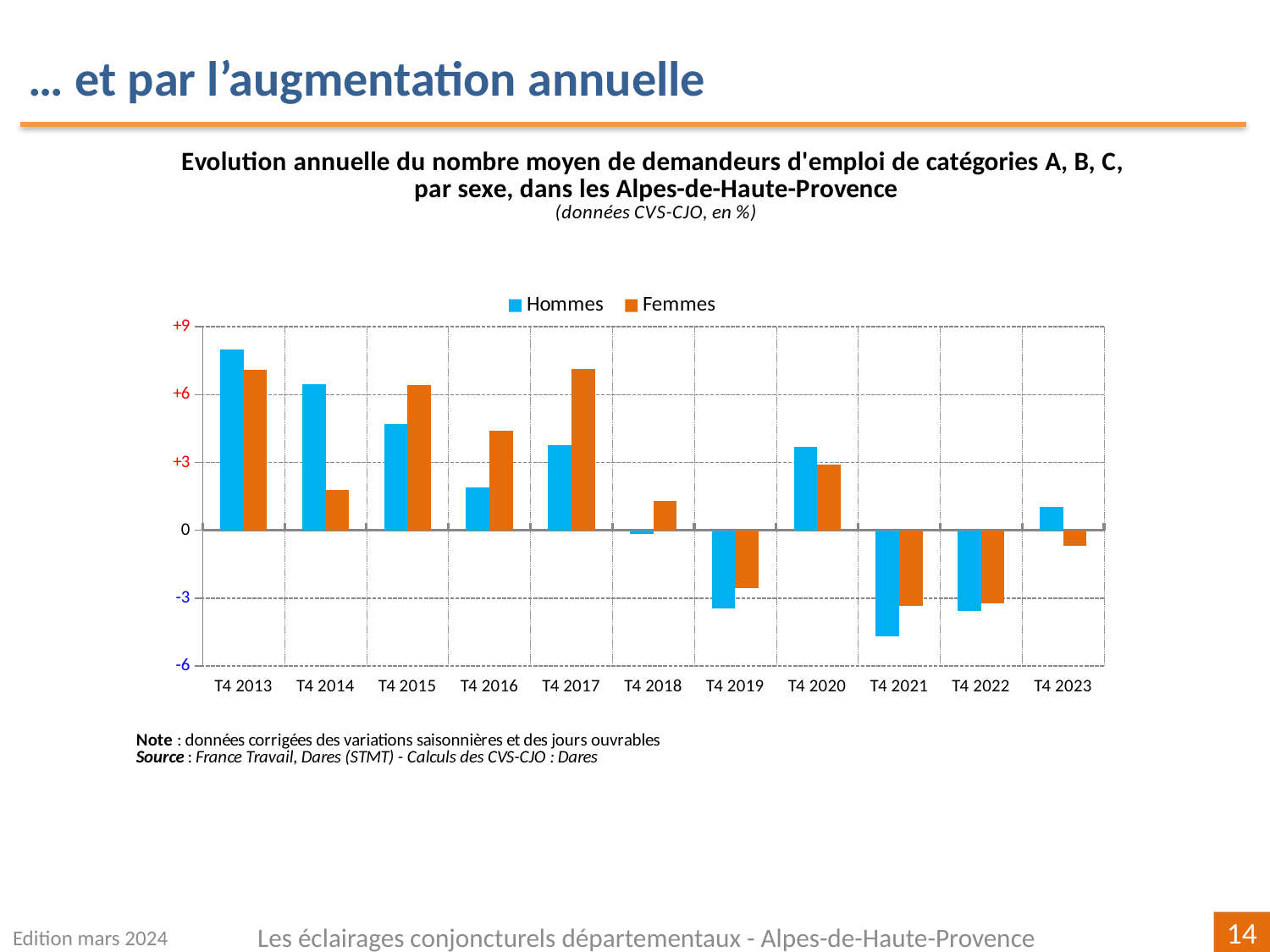
How many series does the legend list? 2 In T4 2015, which series has the larger value, Hommes or Femmes? Femmes Do the Hommes values rise or fall from T4 2013 to T4 2016? fall Is the value for Hommes in T4 2013 greater or less than +6? greater In which quarter is the Hommes value the lowest? T4 2021 Is the value for Femmes in T4 2014 greater or less than +3? less In which quarter is the Hommes value the highest? T4 2013 Is the value for Hommes in T4 2021 greater or less than -3? less What kind of chart is shown on the slide? Bar chart In T4 2014, which series has the larger value, Hommes or Femmes? Hommes Which colour represents the Femmes series in the legend? Orange How many quarters (categories) are shown on the x axis? 11